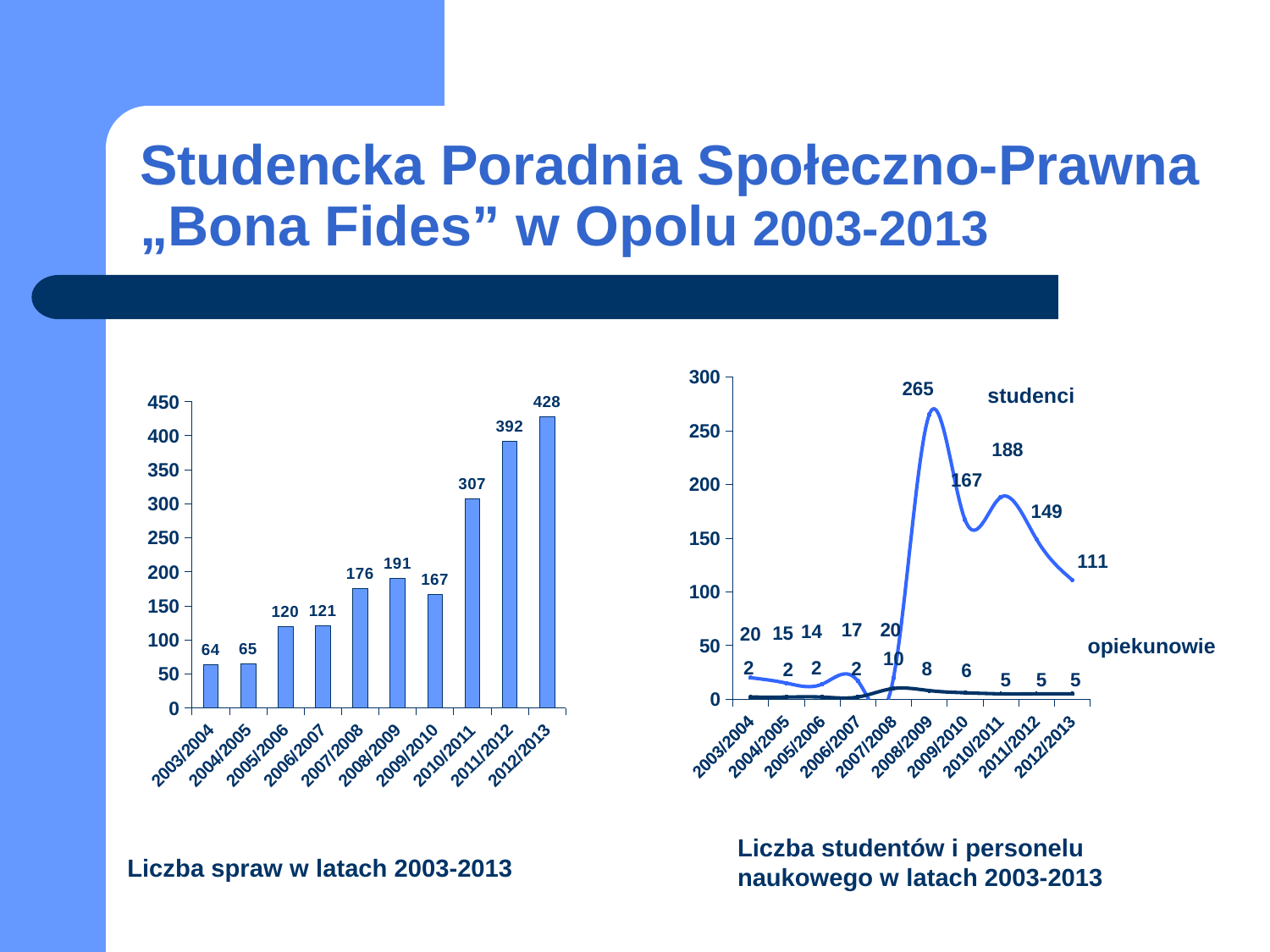
In the left chart (Liczba spraw w latach 2003-2013), how many years are shown on the x axis? 10 In the right chart (Liczba studentów i personelu naukowego), do the studenci values rise or fall from 2008/2009 to 2012/2013? fall What kind of chart is the left chart (Liczba spraw w latach 2003-2013)? bar chart In the right chart (Liczba studentów i personelu naukowego), what is the difference between studenci and opiekunowie in 2012/2013? 106 In the left chart (Liczba spraw w latach 2003-2013), what is the value for 2010/2011? 307 In the right chart (Liczba studentów i personelu naukowego), how many series are plotted? 2 In the left chart (Liczba spraw w latach 2003-2013), what is the difference between the values for 2012/2013 and 2011/2012? 36 In the right chart (Liczba studentów i personelu naukowego), what is the value for studenci in 2008/2009? 265 In the right chart (Liczba studentów i personelu naukowego), what is the value for opiekunowie in 2007/2008? 10 In the left chart (Liczba spraw w latach 2003-2013), which year has the lowest value? 2003/2004 In the left chart (Liczba spraw w latach 2003-2013), which is larger, the value for 2008/2009 or 2009/2010? 2008/2009 In the left chart (Liczba spraw w latach 2003-2013), which year has the highest value? 2012/2013